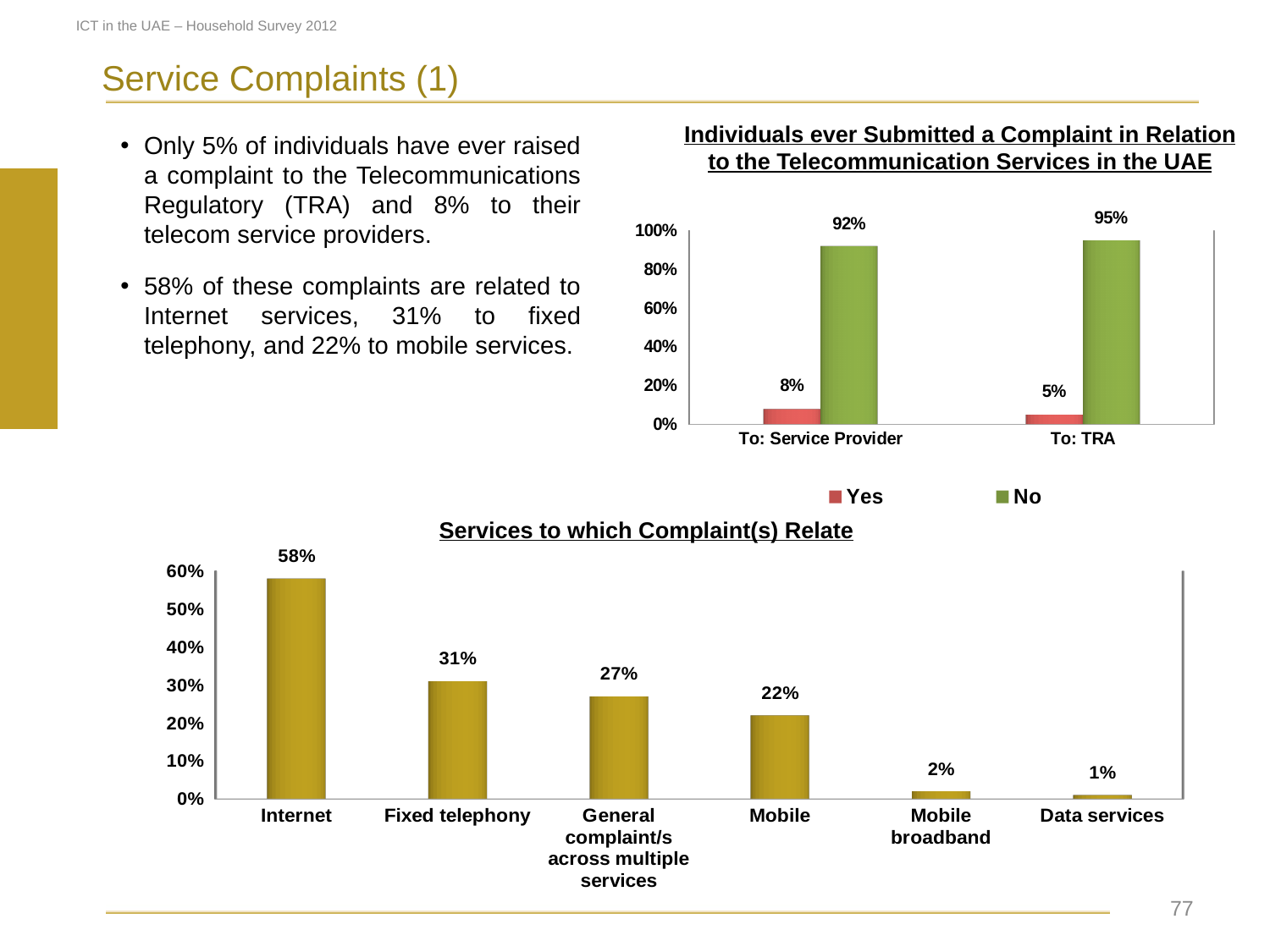
In the 'Services to which Complaint(s) Relate' chart, how many categories are shown? 6 In the 'Services to which Complaint(s) Relate' chart, which category has the highest value? Internet What kind of chart is the 'Services to which Complaint(s) Relate' chart? Bar chart In the 'Services to which Complaint(s) Relate' chart, what is the difference between the values for 'Internet' and 'Mobile'? 36% In the 'Individuals ever Submitted a Complaint in Relation to the Telecommunication Services in the UAE' chart, which colour represents the 'No' series? Green In the 'Individuals ever Submitted a Complaint in Relation to the Telecommunication Services in the UAE' chart, how many series does the legend list? 2 In the 'Individuals ever Submitted a Complaint in Relation to the Telecommunication Services in the UAE' chart, what is the 'No' value for 'To: TRA'? 95% In the 'Individuals ever Submitted a Complaint in Relation to the Telecommunication Services in the UAE' chart, what is the difference between the 'Yes' values for 'To: Service Provider' and 'To: TRA'? 3% In the 'Services to which Complaint(s) Relate' chart, what is the value for 'Fixed telephony'? 31% In the 'Services to which Complaint(s) Relate' chart, which is larger: 'General complaint/s across multiple services' or 'Mobile'? General complaint/s across multiple services In the 'Individuals ever Submitted a Complaint in Relation to the Telecommunication Services in the UAE' chart, what is the 'Yes' value for 'To: Service Provider'? 8% In the 'Services to which Complaint(s) Relate' chart, which category has the lowest value? Data services